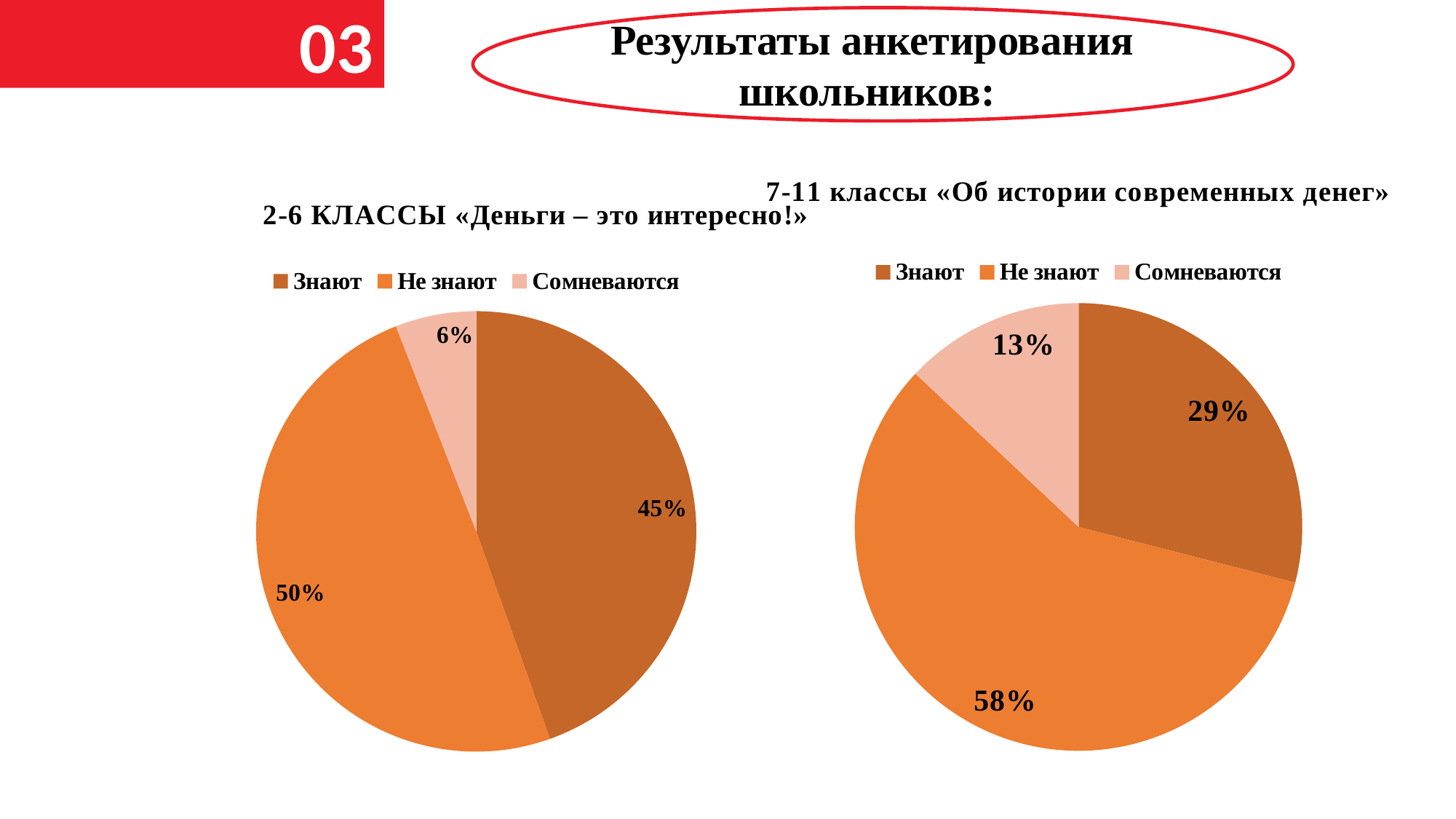
In the right pie chart (7-11 классы), which category has the largest slice? Не знают What type of chart is used for the 2-6 классы data on the left? Pie chart In the left pie chart (2-6 классы), what share is labelled for «Сомневаются»? 6% In the right pie chart (7-11 классы), what share is labelled for «Сомневаются»? 13% In the left pie chart (2-6 классы «Деньги – это интересно!»), what share is labelled for «Знают»? 45% In the left pie chart (2-6 классы), what share is labelled for «Не знают»? 50% In the left pie chart (2-6 классы), which category has the smallest slice? Сомневаются In the right pie chart (7-11 классы «Об истории современных денег»), what share is labelled for «Знают»? 29% In the right pie chart (7-11 классы), what share is labelled for «Не знают»? 58% Which is larger in the left pie chart (2-6 классы): «Знают» or «Не знают»? Не знают How many categories does the legend of the right pie chart (7-11 классы) list? 3 In the right pie chart (7-11 классы), what is the difference between the «Не знают» and «Знают» shares? 29%